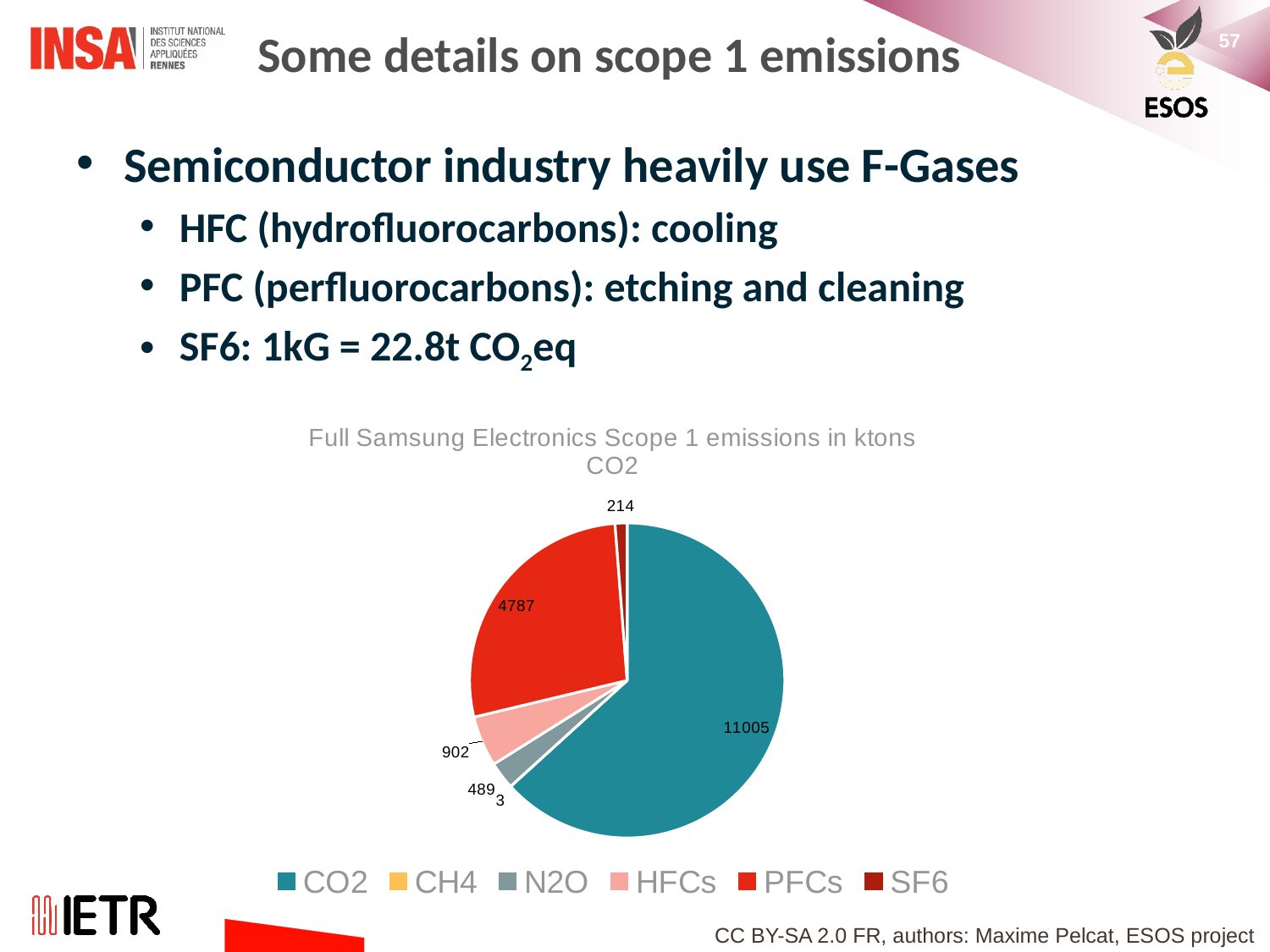
What is the value for SF6 in the pie chart? 214 What is the difference between the CO2 value and the PFCs value? 6218 What kind of chart is shown on the slide? Pie chart Which category has the smallest slice of the pie chart? CH4 Which category has the largest slice of the pie chart? CO2 What is the value for PFCs in the pie chart? 4787 What is the value for HFCs in the pie chart? 902 How many categories does the pie chart legend list? 6 What is the value for CO2 in the pie chart? 11005 What is the value for N2O in the pie chart? 489 Which is larger, the value for HFCs or the value for N2O? HFCs What is the title of the chart? Full Samsung Electronics Scope 1 emissions in ktons CO2